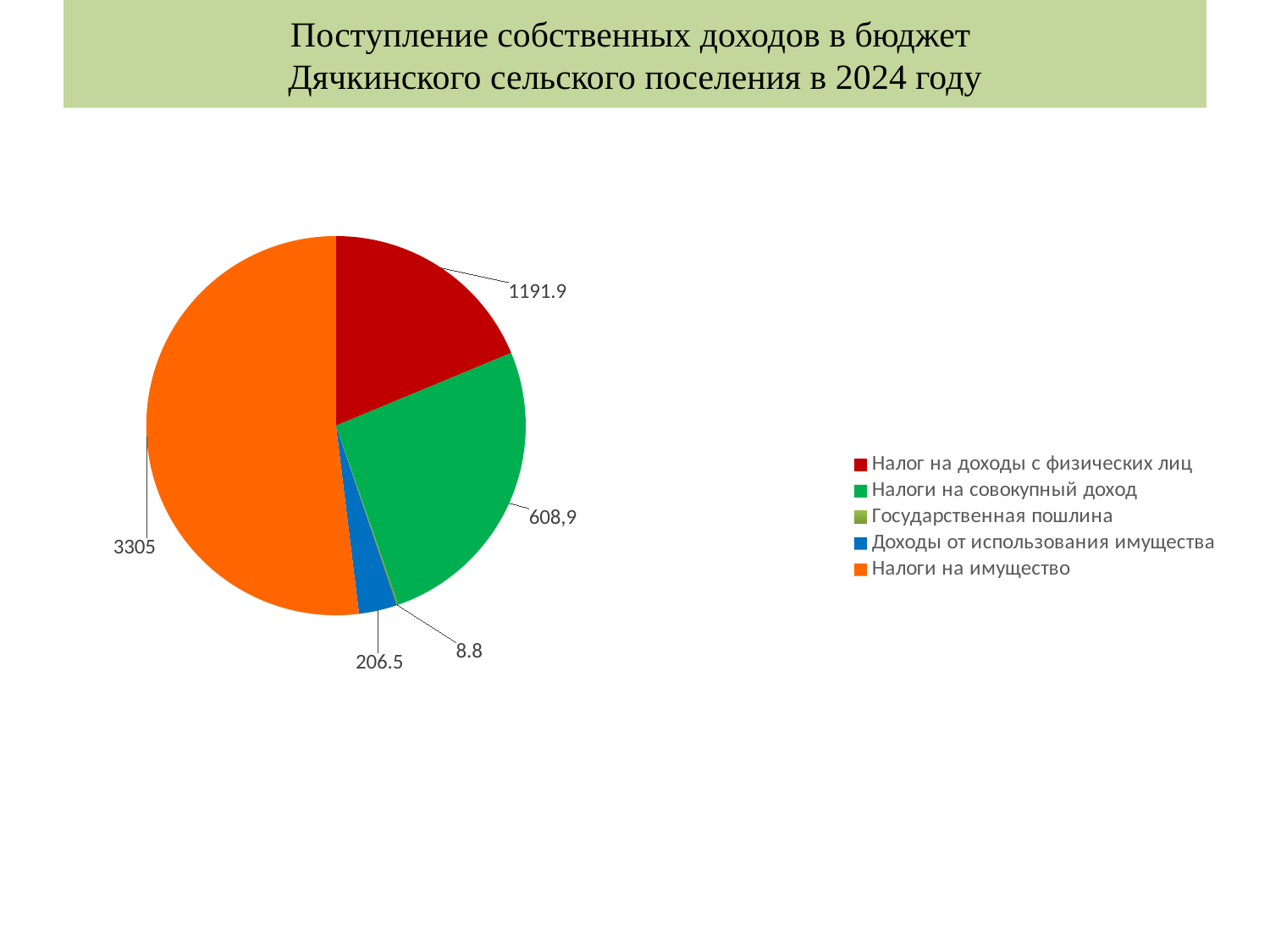
Which category has the smallest slice of the pie? Государственная пошлина What is the value for Налог на доходы с физических лиц? 1191.9 What is the difference between the values for Налоги на имущество and Налог на доходы с физических лиц? 2113.1 What is the value for Налоги на совокупный доход? 608,9 How many categories does the pie chart show? 5 Which category has the largest slice of the pie? Налоги на имущество What is the value for Доходы от использования имущества? 206.5 What colour is the slice for Доходы от использования имущества? blue What is the value for Государственная пошлина? 8.8 What type of chart is shown on the slide? pie chart What is the value for Налоги на имущество? 3305